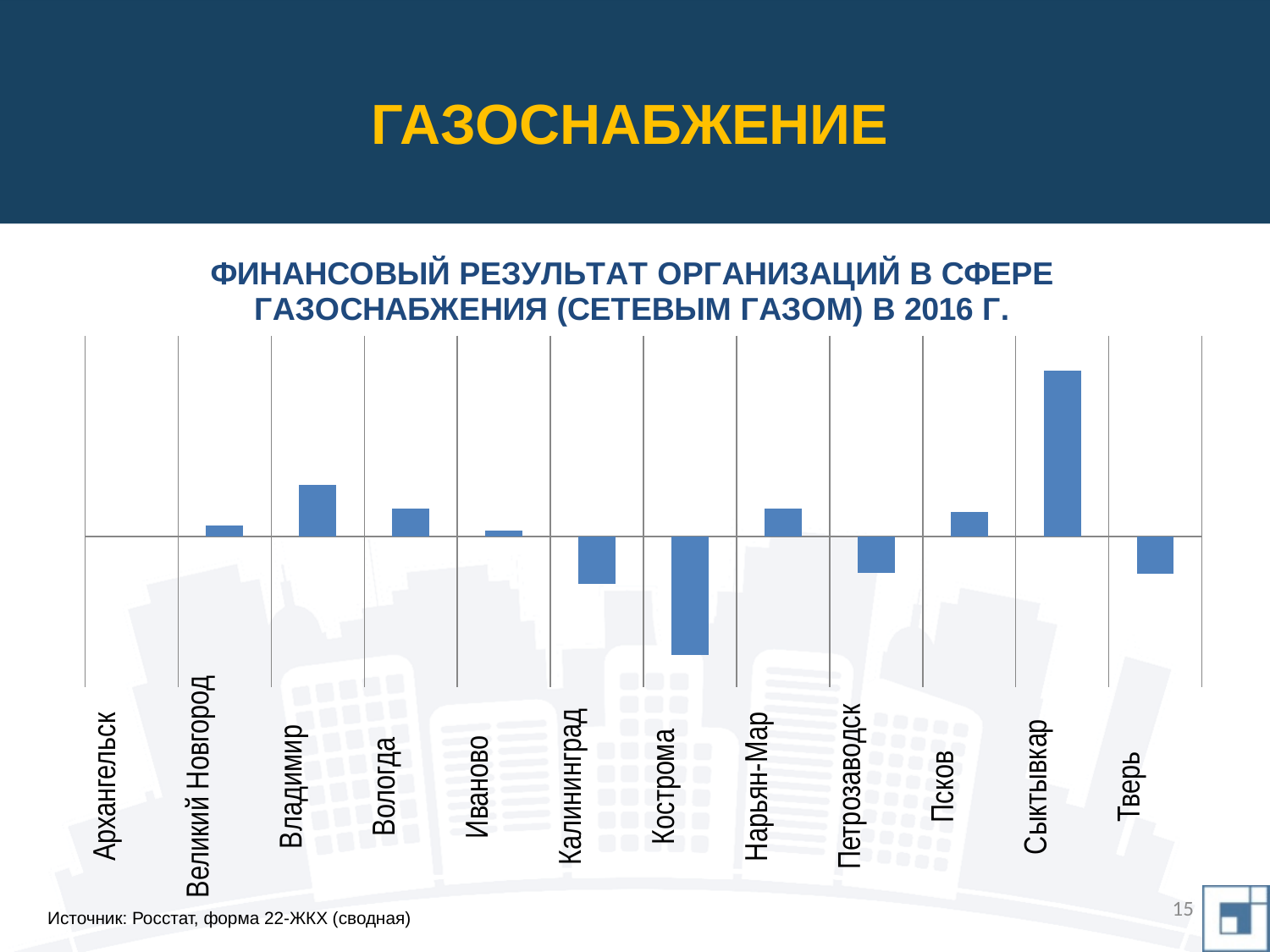
Which city has the larger value, Псков or Тверь? Псков Which city has the larger value, Сыктывкар or Владимир? Сыктывкар What source is cited for the chart data? Росстат, форма 22-ЖКХ (сводная) Which city has the lower value, Кострома or Калининград? Кострома How many cities are shown on the x axis of the chart? 12 What kind of chart is shown on the slide? bar chart What is the title of the chart? ФИНАНСОВЫЙ РЕЗУЛЬТАТ ОРГАНИЗАЦИЙ В СФЕРЕ ГАЗОСНАБЖЕНИЯ (СЕТЕВЫМ ГАЗОМ) В 2016 Г. Which city has the lowest financial result in the chart? Кострома Which city has the highest financial result in the chart? Сыктывкар